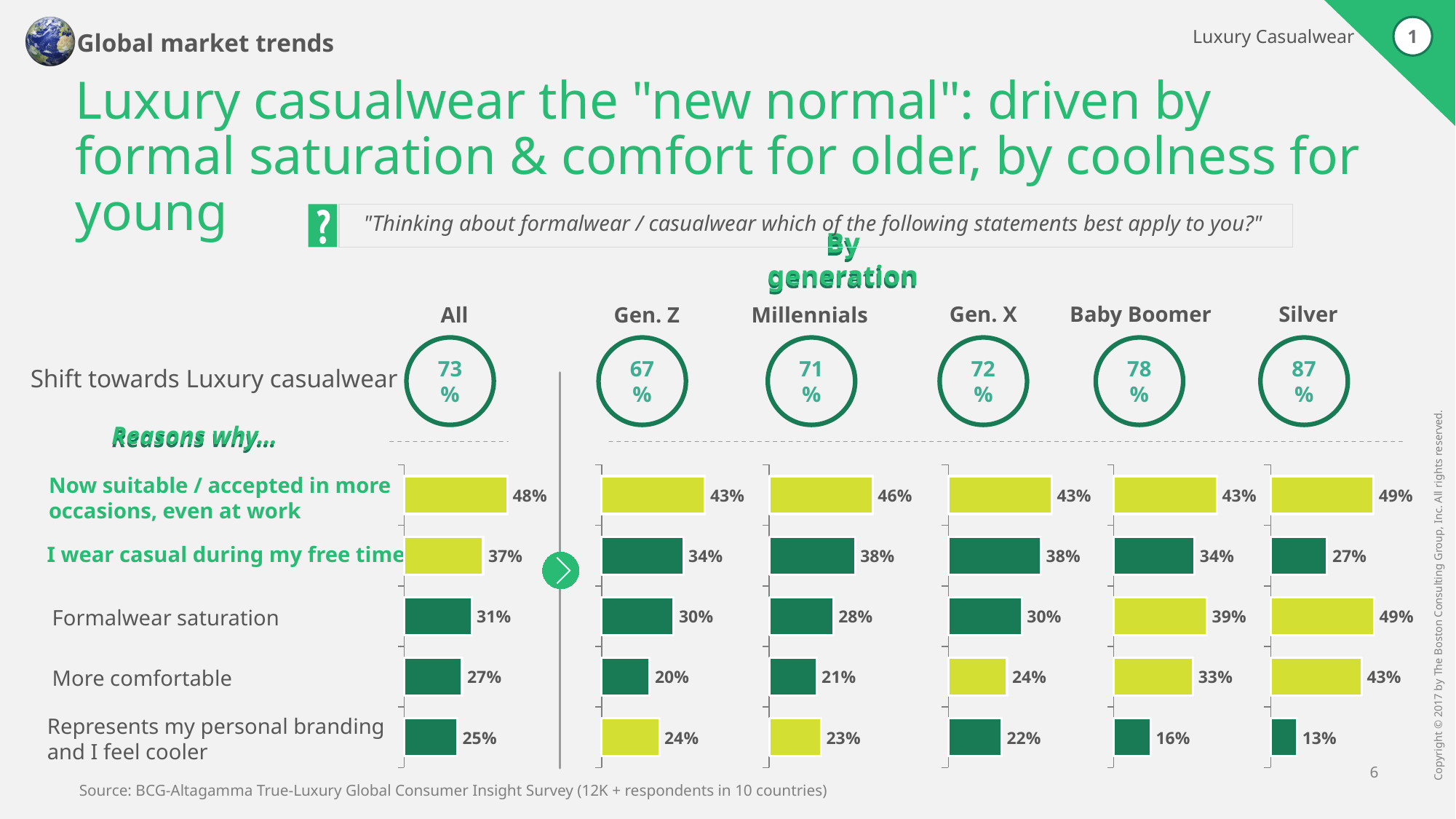
In the "Baby Boomer" chart, which is larger: "Formalwear saturation" or "I wear casual during my free time"? Formalwear saturation In the "Baby Boomer" chart, what percentage is shown for "Formalwear saturation"? 39% What is the "Shift towards Luxury casualwear" percentage shown in the circle for the "Silver" generation? 87% In the "All" chart, what percentage is shown for "Now suitable / accepted in more occasions, even at work"? 48% In the "Millennials" chart, which reason has the highest percentage? Now suitable / accepted in more occasions, even at work How many generation columns are shown under the "By generation" heading? 5 In the "Silver" chart, what percentage is shown for "More comfortable"? 43% How many reasons (categories) are plotted in each bar chart? 5 What kind of chart is used to show the reasons for each generation? Bar chart In the "Gen. X" chart, what is the difference between "I wear casual during my free time" and "More comfortable"? 14% In the "Gen. Z" chart, which reason has the lowest percentage? More comfortable In the "Silver" chart, which reason has the lowest percentage? Represents my personal branding and I feel cooler